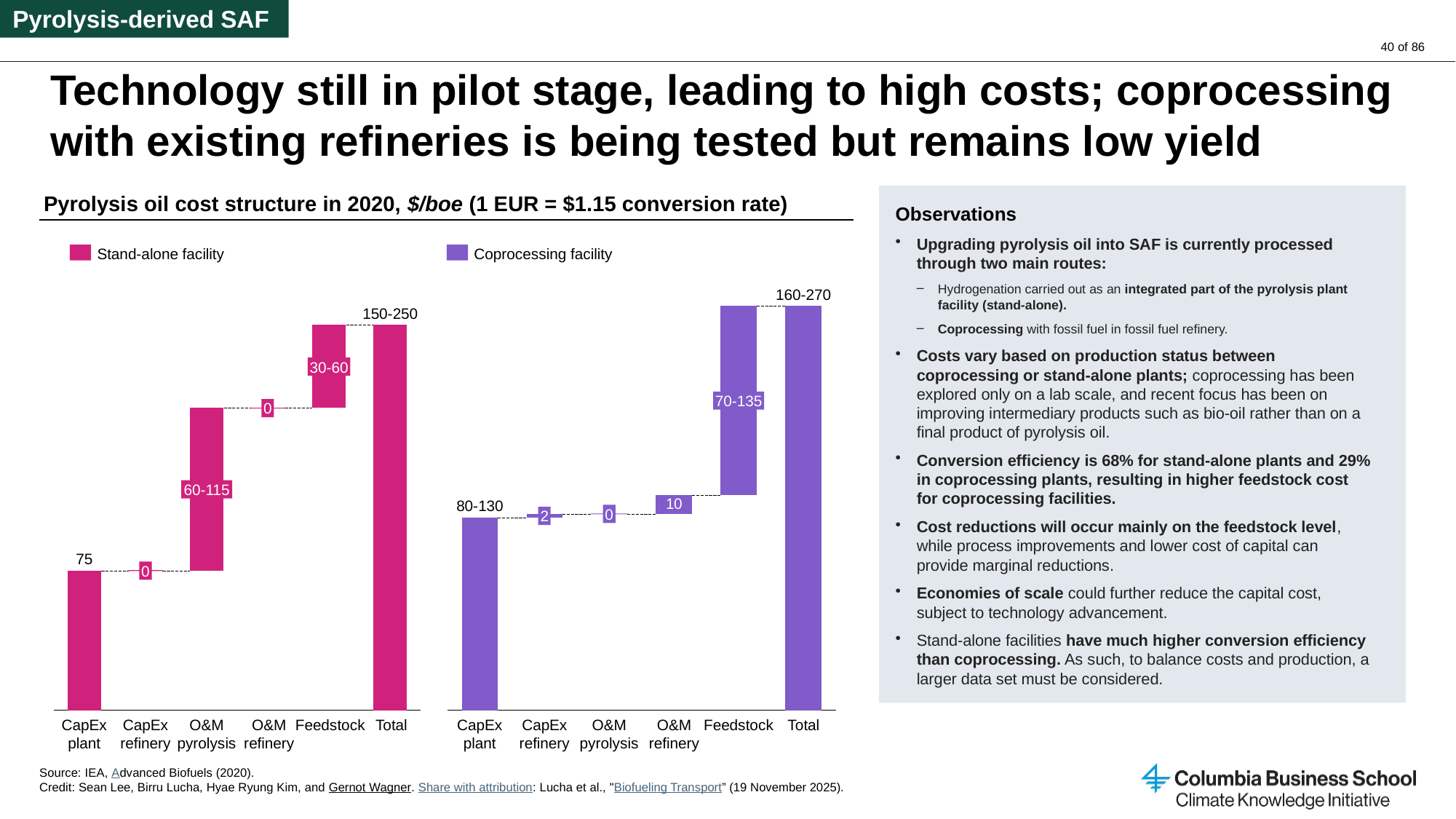
In the Coprocessing facility chart, what is the Total? 160-270 In the Coprocessing facility chart, what is the value for O&M refinery? 10 In the Stand-alone facility chart, what is the Total? 150-250 In the Coprocessing facility chart, what is the value for Feedstock? 70-135 In the Stand-alone facility chart, what is the value for O&M pyrolysis? 60-115 How many cost categories are shown on the x axis of the Stand-alone facility chart? 6 What unit is the pyrolysis oil cost structure expressed in, according to the chart title? $/boe In the Stand-alone facility chart, what is the value for Feedstock? 30-60 Which facility has the higher Feedstock cost, Stand-alone or Coprocessing? Coprocessing In the Coprocessing facility chart, what is the value for CapEx plant? 80-130 What kind of chart is used to show the pyrolysis oil cost structure? Bar chart (waterfall) In the Stand-alone facility chart, what is the value for CapEx plant? 75